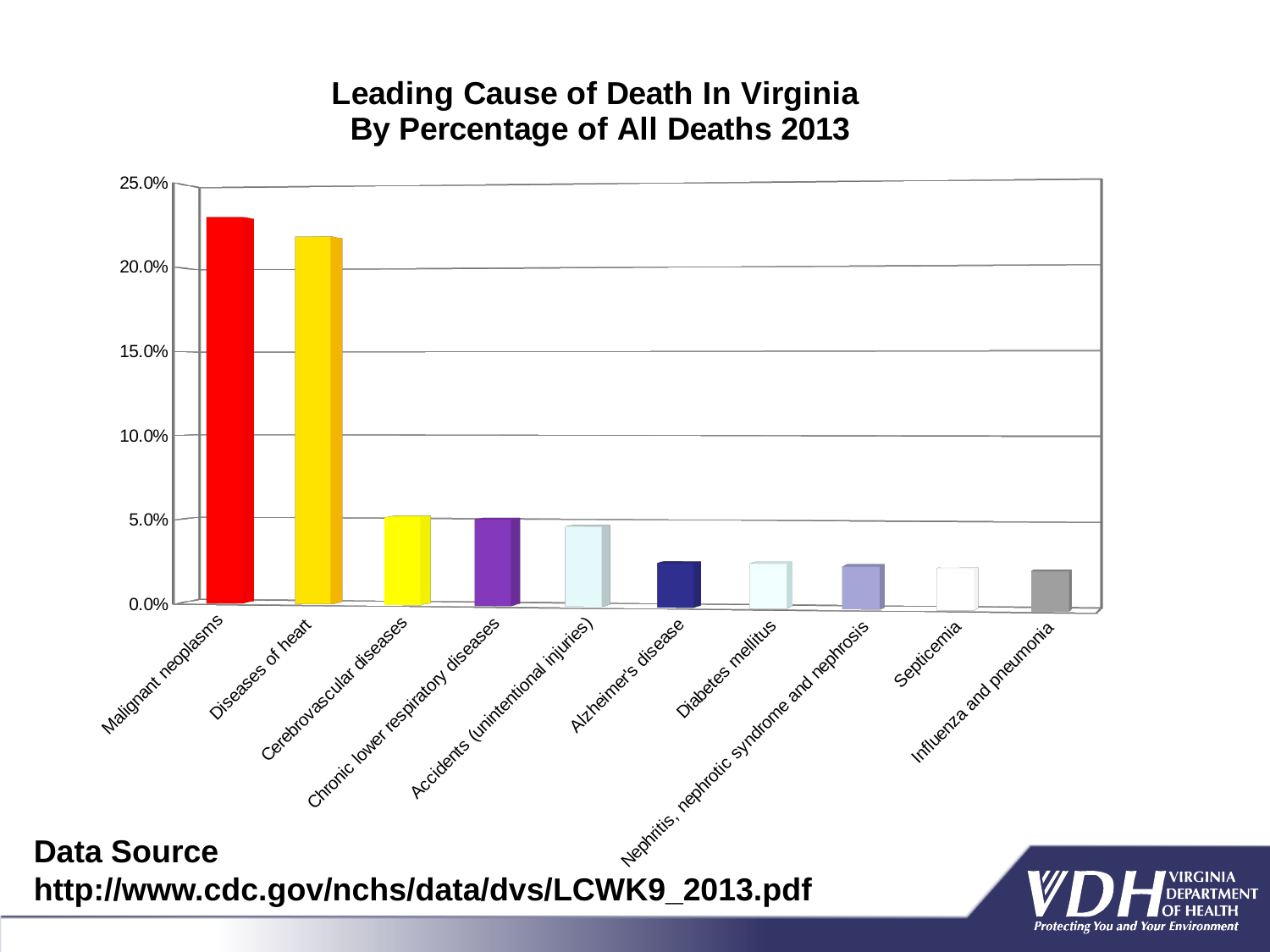
How many causes of death are plotted on the chart? 10 Which is larger, the value for Malignant neoplasms or the value for Alzheimer's disease? Malignant neoplasms Which cause of death has the highest percentage of all deaths? Malignant neoplasms Is the value for Diseases of heart greater or less than 20.0%? greater Which is larger, the value for Diseases of heart or the value for Cerebrovascular diseases? Diseases of heart Do the values generally rise or fall moving from left to right along the x axis? Fall Is the value for Influenza and pneumonia greater or less than 5.0%? less Is the value for Alzheimer's disease greater or less than 5.0%? less What is the title of the chart? Leading Cause of Death In Virginia By Percentage of All Deaths 2013 What kind of chart is shown on the slide? Bar chart